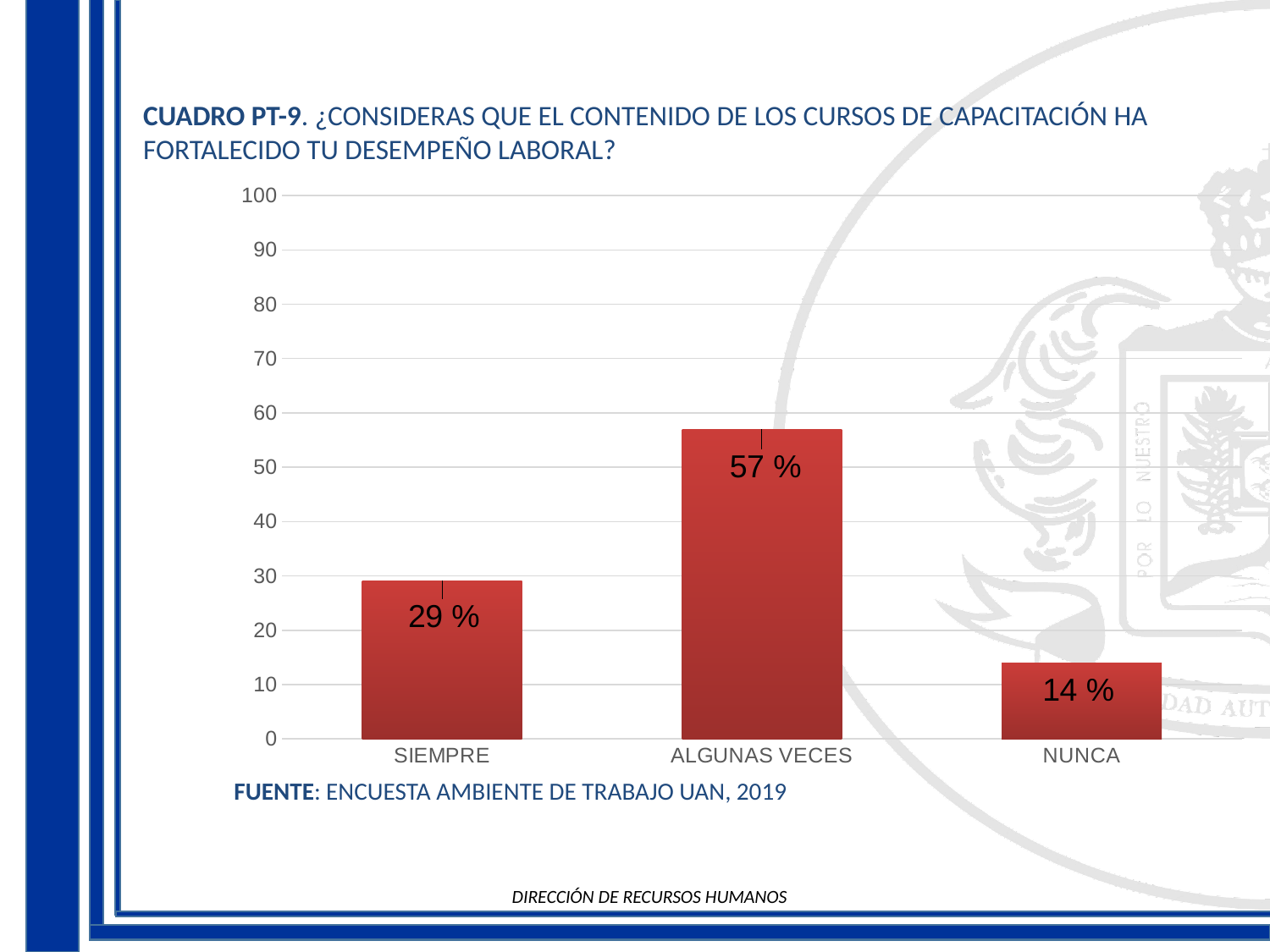
Which category has the highest value? ALGUNAS VECES Which category has the lowest value? NUNCA What is the difference between the values for SIEMPRE and NUNCA? 15 % Is the value for ALGUNAS VECES greater or less than 50? greater What is the difference between the values for ALGUNAS VECES and SIEMPRE? 28 % What is the source cited below the chart? ENCUESTA AMBIENTE DE TRABAJO UAN, 2019 What is the value for SIEMPRE? 29 % How many categories are shown on the x axis? 3 What kind of chart is shown on the slide? bar chart What is the value for NUNCA? 14 % Which is larger, the value for SIEMPRE or the value for NUNCA? SIEMPRE What is the value for ALGUNAS VECES? 57 %